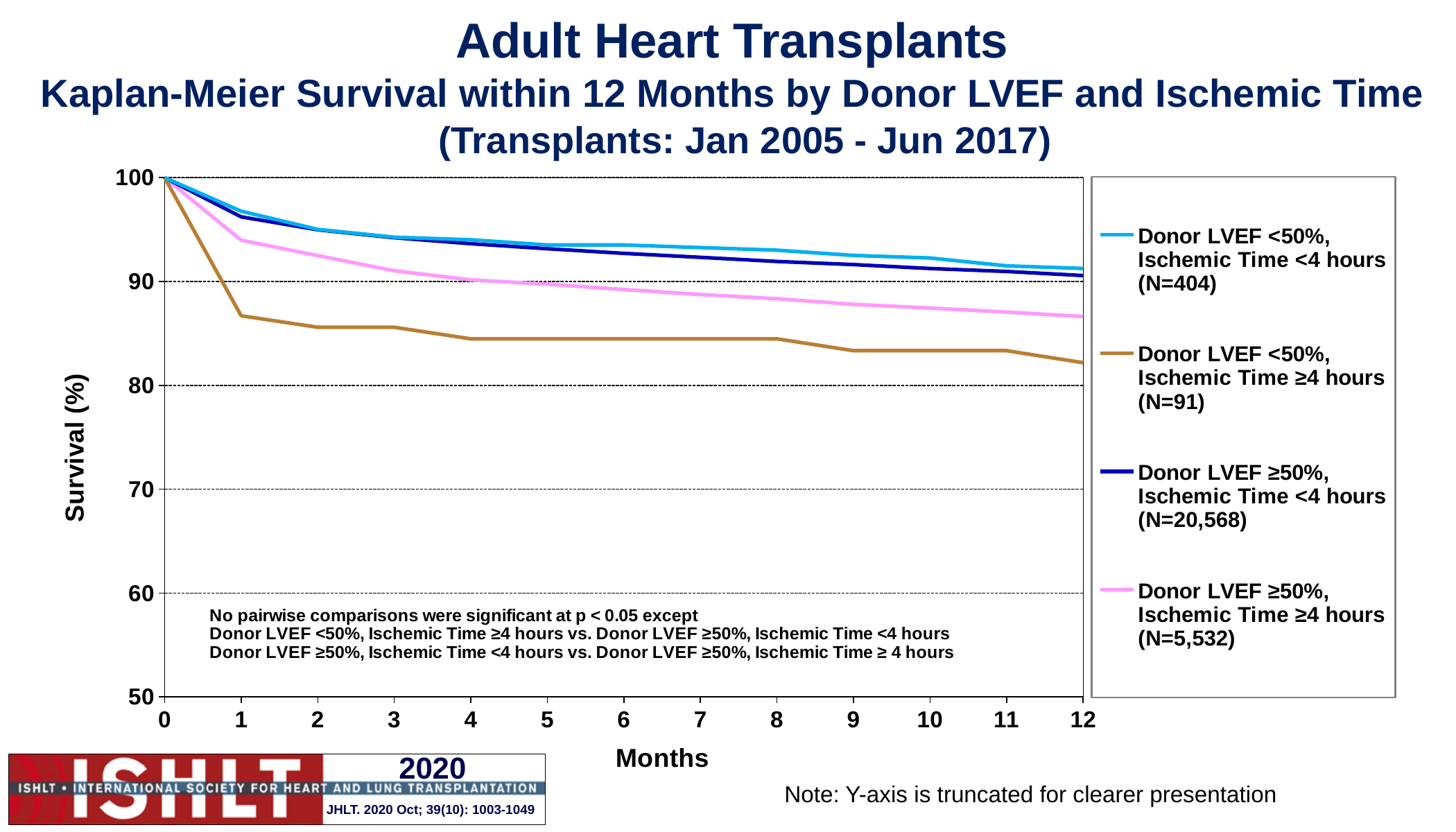
What kind of chart is shown on the slide? line chart At month 6, which has higher survival: Donor LVEF ≥50%, Ischemic Time ≥4 hours or Donor LVEF <50%, Ischemic Time ≥4 hours? Donor LVEF ≥50%, Ischemic Time ≥4 hours What is the survival value for all series at month 0? 100 Is the survival for Donor LVEF <50%, Ischemic Time ≥4 hours at 12 months greater or less than 80? greater Which series has the lowest survival at 12 months? Donor LVEF <50%, Ischemic Time ≥4 hours Is the survival for Donor LVEF <50%, Ischemic Time ≥4 hours at 12 months greater or less than 90? less Do the survival curves rise or fall as months increase? fall Is the survival for Donor LVEF <50%, Ischemic Time <4 hours at 12 months greater or less than 90? greater What is the label of the y-axis? Survival (%) How many series does the legend list? 4 What is the N for the Donor LVEF ≥50%, Ischemic Time <4 hours group in the legend? N=20,568